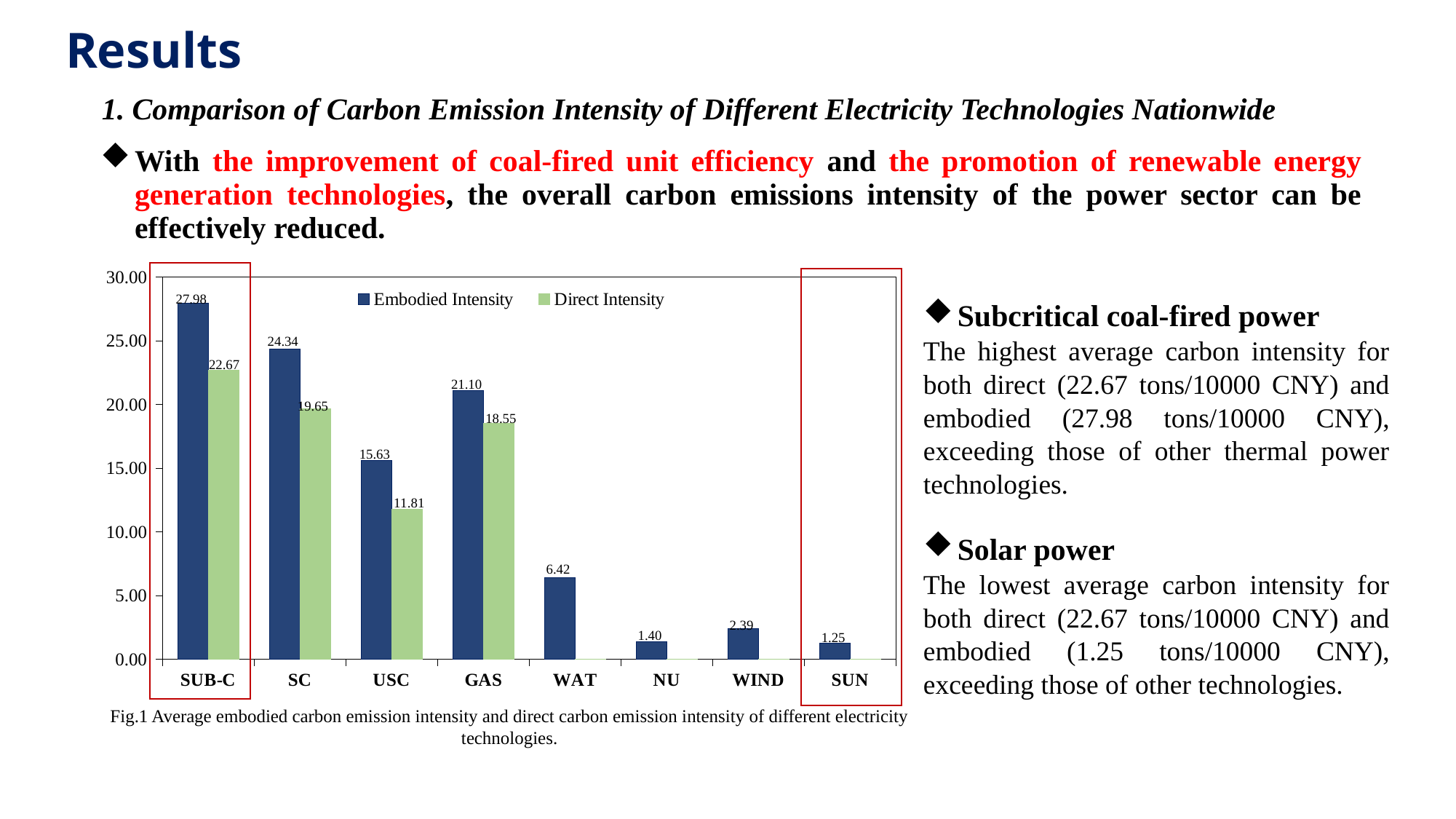
Which is larger, the Embodied Intensity for GAS or the Embodied Intensity for SC? SC Which category has the highest Embodied Intensity? SUB-C What is the Direct Intensity value for SC? 19.65 What colour are the Direct Intensity bars? green Is the Embodied Intensity for WIND greater or less than 5.00? less How many series does the legend list? 2 What kind of chart is shown on the slide? bar chart What is the Embodied Intensity value for WAT? 6.42 What is the difference between the Embodied Intensity and Direct Intensity for USC? 3.82 How many categories are shown on the x axis? 8 What is the Embodied Intensity value for SUB-C? 27.98 Which category has the lowest Embodied Intensity? SUN